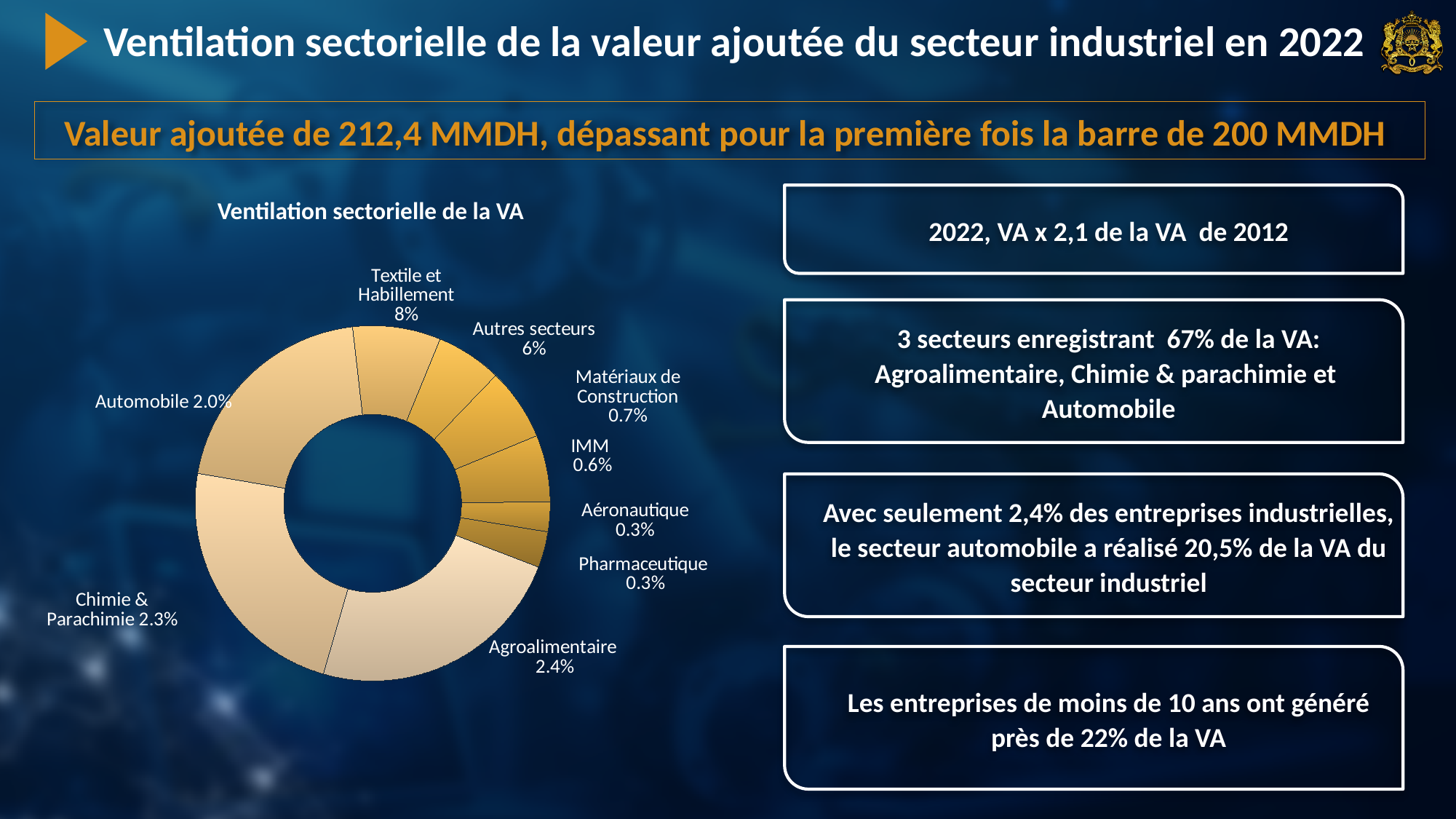
What value is shown for Matériaux de Construction? 0.7% What value is shown for Automobile? 2.0% What value is shown for Aéronautique? 0.3% Which has the larger labelled value, Textile et Habillement or Autres secteurs? Textile et Habillement What value is shown for Autres secteurs? 6% What value is shown for IMM? 0.6% What value is shown for Chimie & Parachimie? 2.3% What value is shown for Agroalimentaire? 2.4% What value is shown for Textile et Habillement? 8% What kind of chart is shown on the slide? Doughnut (pie) chart What is the title of the chart? Ventilation sectorielle de la VA How many sectors (slices) are shown in the chart? 9